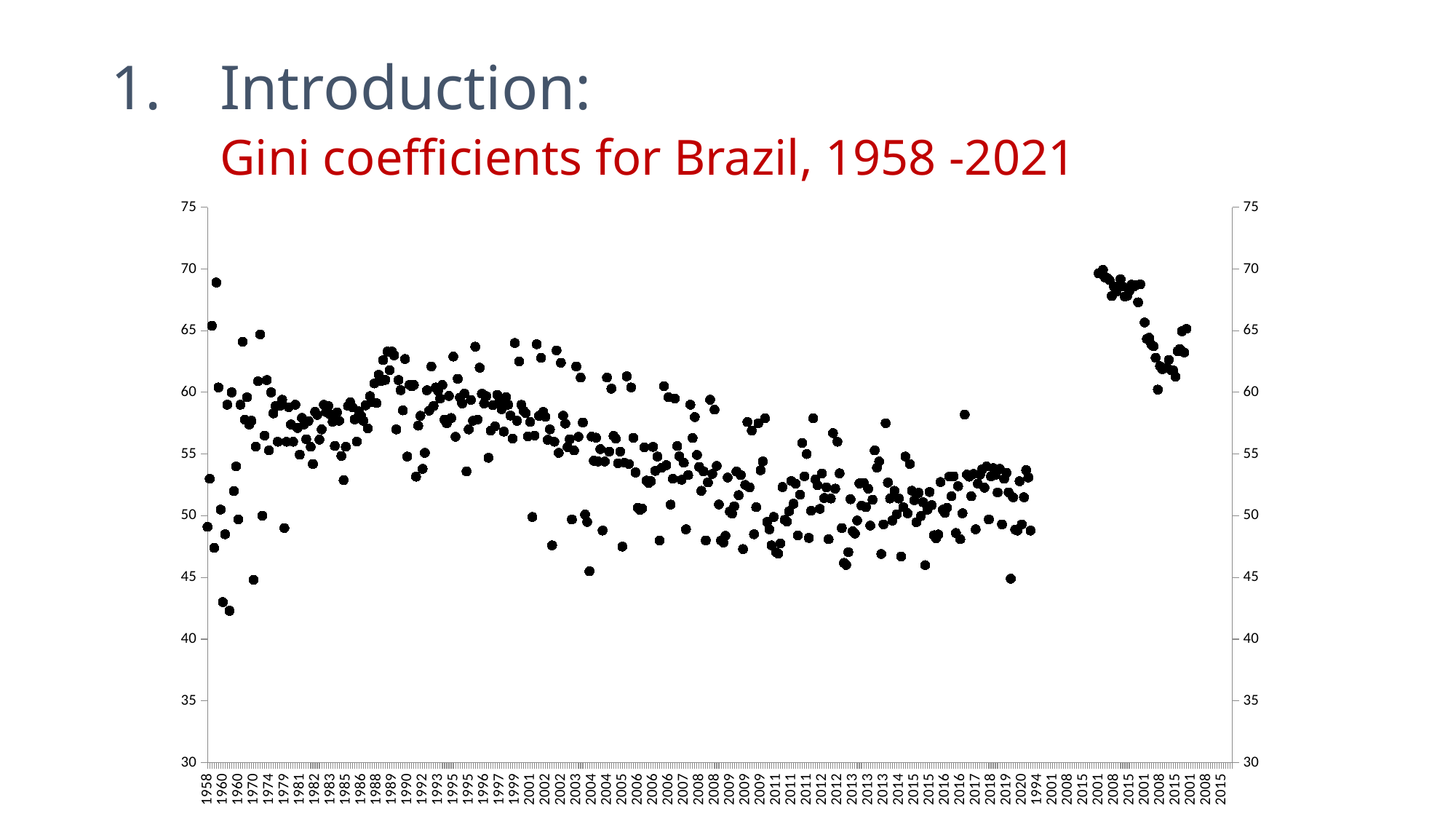
What is the title of the chart on the slide? Gini coefficients for Brazil, 1958 -2021 What kind of chart is shown on the slide? Scatter chart What colour are the plotted markers on the chart? Black What is the first year label on the horizontal axis of the chart? 1958 Are any points on the chart plotted below 40? No What is the lowest value shown on the vertical axis of the chart? 30 What is the highest value shown on the vertical axis of the chart? 75 Is the lowest plotted point on the chart greater or less than 45? less